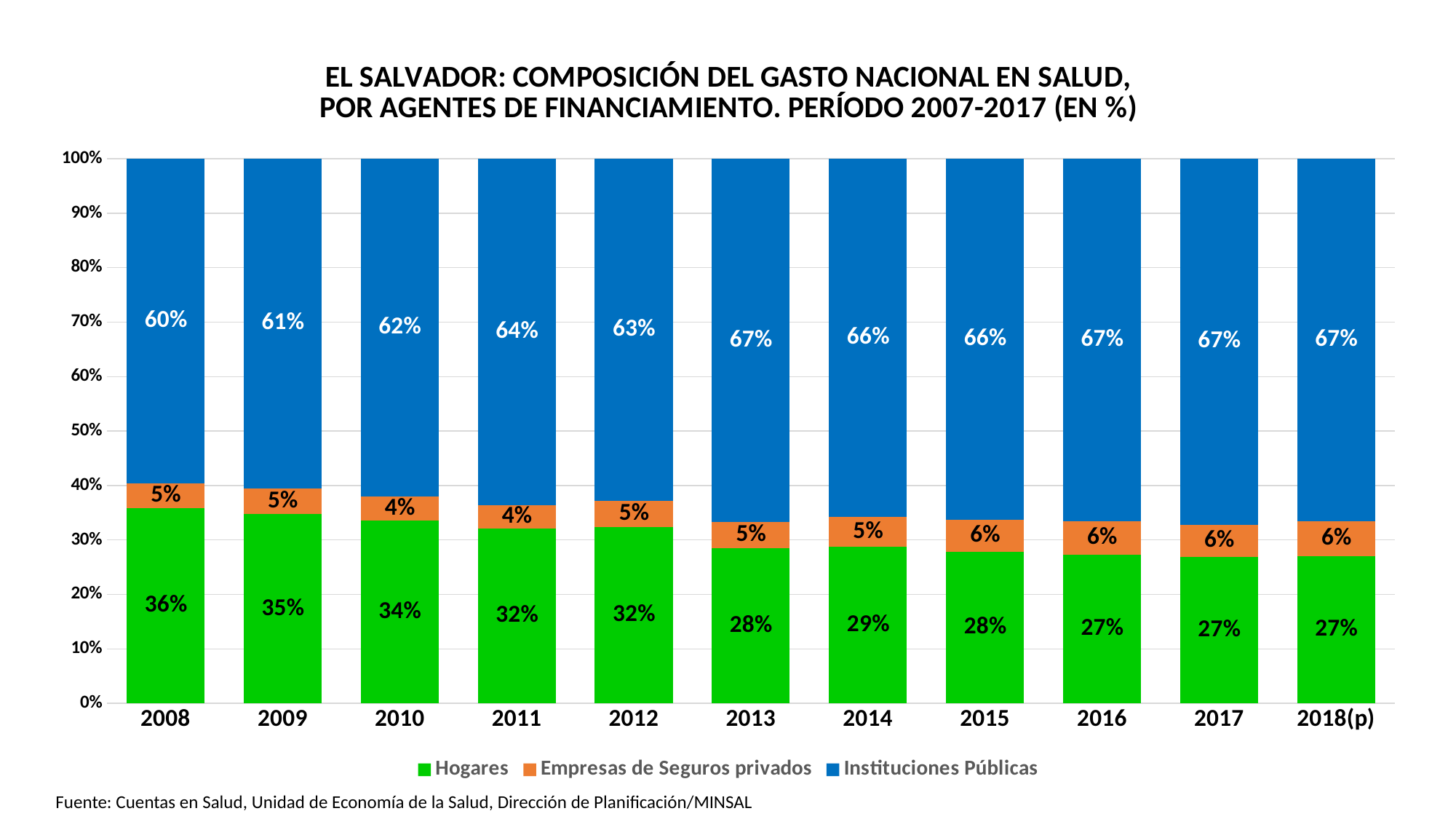
What is the difference between the Instituciones Públicas value in 2017 and in 2008? 7% In which year is the Hogares share highest? 2008 What kind of chart is this? Stacked bar chart Does the Hogares share rise or fall from 2008 to 2018(p)? Fall Which is larger, the Hogares value in 2010 or in 2014? 2010 What is the value for Hogares in 2008? 36% What is the value for Instituciones Públicas in 2013? 67% In which year is the Instituciones Públicas share lowest? 2008 What is the value for Empresas de Seguros privados in 2011? 4% What is the value for Hogares in 2018(p)? 27% How many years are shown on the x axis? 11 How many series does the legend list? 3